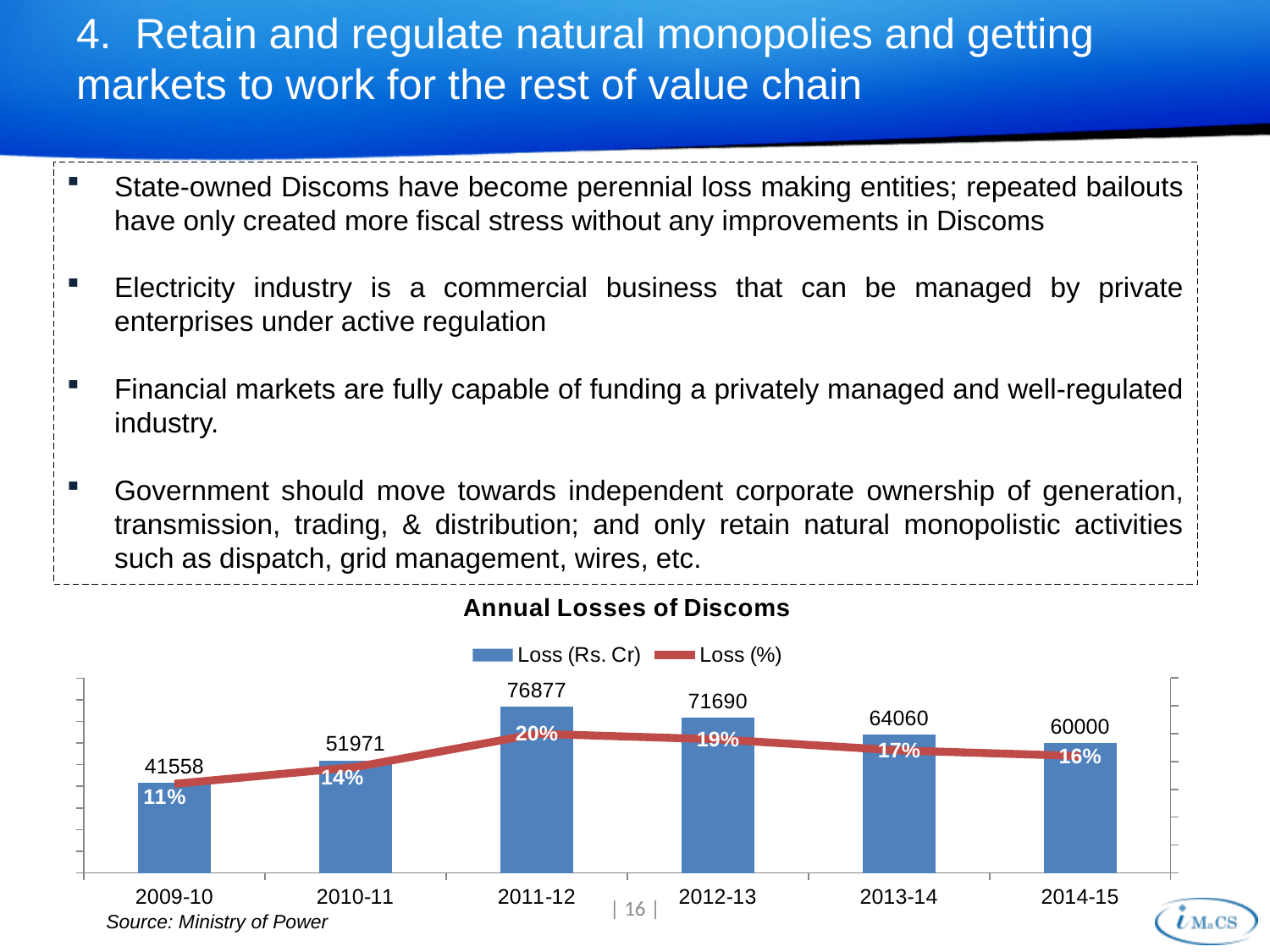
Which is larger, the Loss (Rs. Cr) for 2012-13 or for 2013-14? 2012-13 What kind of chart is used to show Loss (Rs. Cr)? Bar chart Which year has the lowest Loss (%)? 2009-10 What is the Loss (%) value for 2009-10? 11% What is the title of the chart? Annual Losses of Discoms How many series does the legend list? 2 Which year has the highest Loss (Rs. Cr)? 2011-12 How many years are shown on the x axis? 6 What is the Loss (Rs. Cr) value for 2014-15? 60000 What is the Loss (Rs. Cr) value for 2011-12? 76877 What is the difference in Loss (%) between 2011-12 and 2014-15? 4% What is the difference in Loss (Rs. Cr) between 2011-12 and 2009-10? 35319